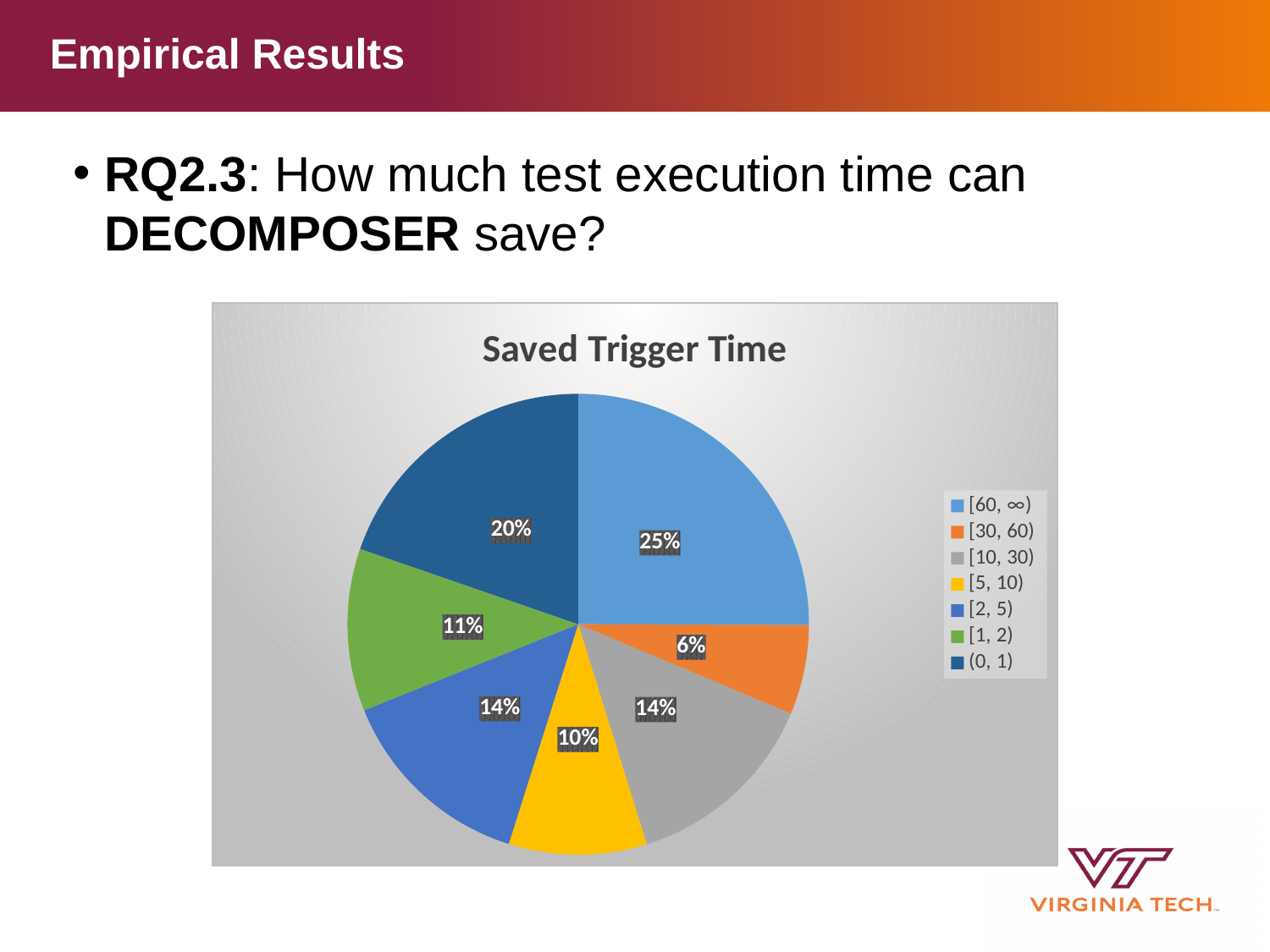
Which category has the largest share of the pie? [60, ∞) What is the difference in percentage points between the [60, ∞) slice and the (0, 1) slice? 5 How many slices does the pie chart have? 7 What share of the pie does the [5, 10) category have? 10% Which category has the smallest share of the pie? [30, 60) Which is larger, the share for [1, 2) or the share for [2, 5)? [2, 5) What share of the pie does the [1, 2) category have? 11% What kind of chart is shown on the slide? pie chart What share of the pie does the (0, 1) category have? 20% What is the title of the chart? Saved Trigger Time